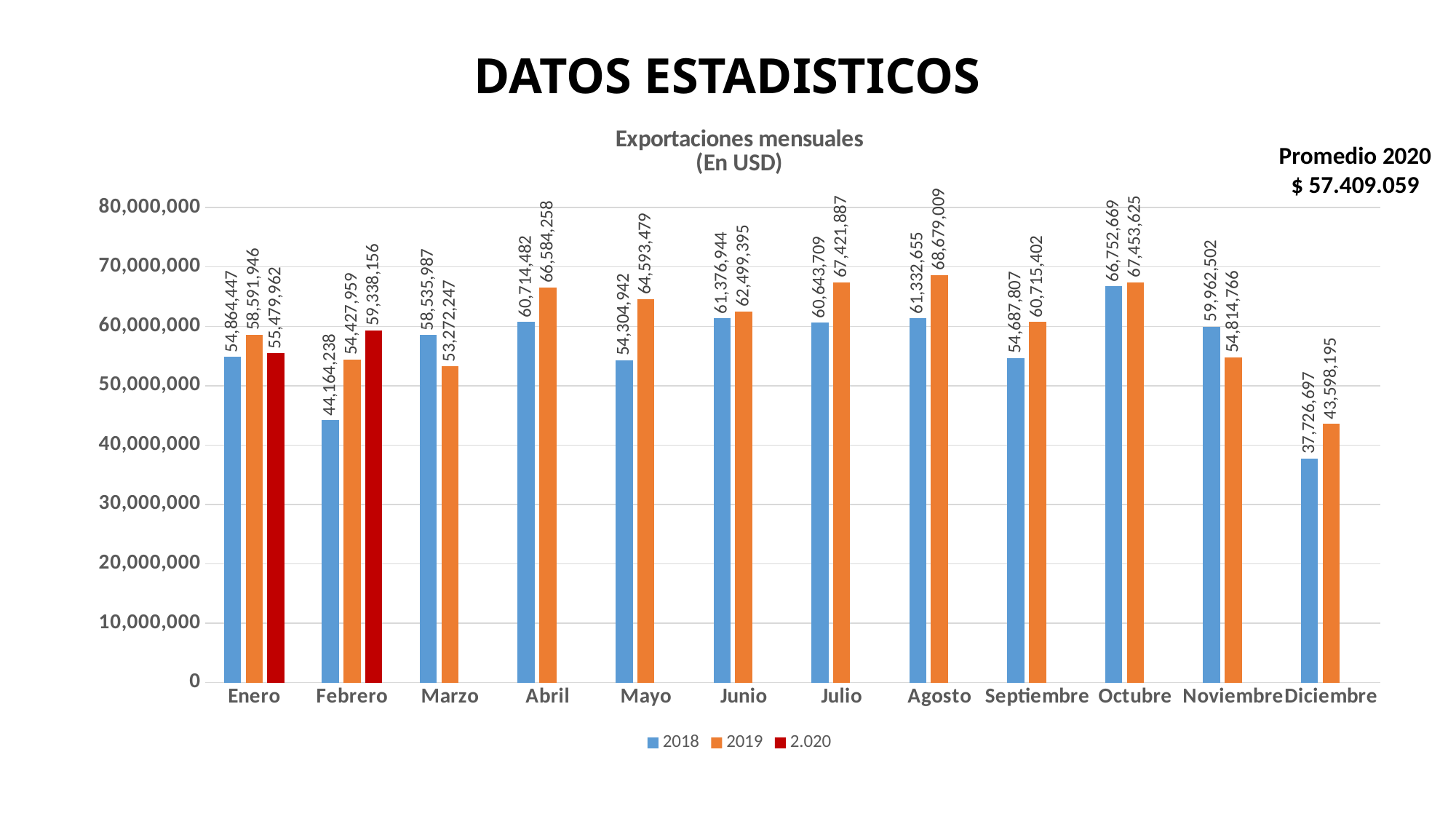
How many months are shown on the x axis? 12 Is the 2018 export value for Febrero greater or less than 50,000,000? less Which is larger for Noviembre, the 2018 value or the 2019 value? 2018 Which month has the lowest 2018 export value? Diciembre What is the 2.020 export value for Febrero? 59,338,156 How many series does the legend list? 3 Which month has the highest 2019 export value? Agosto What is the title of the chart? Exportaciones mensuales (En USD) What kind of chart is shown on the slide? bar chart What is the 2019 export value for Agosto? 68,679,009 What is the 2018 export value for Diciembre? 37,726,697 What is the difference between the 2.020 and 2019 export values for Febrero? 4,910,197